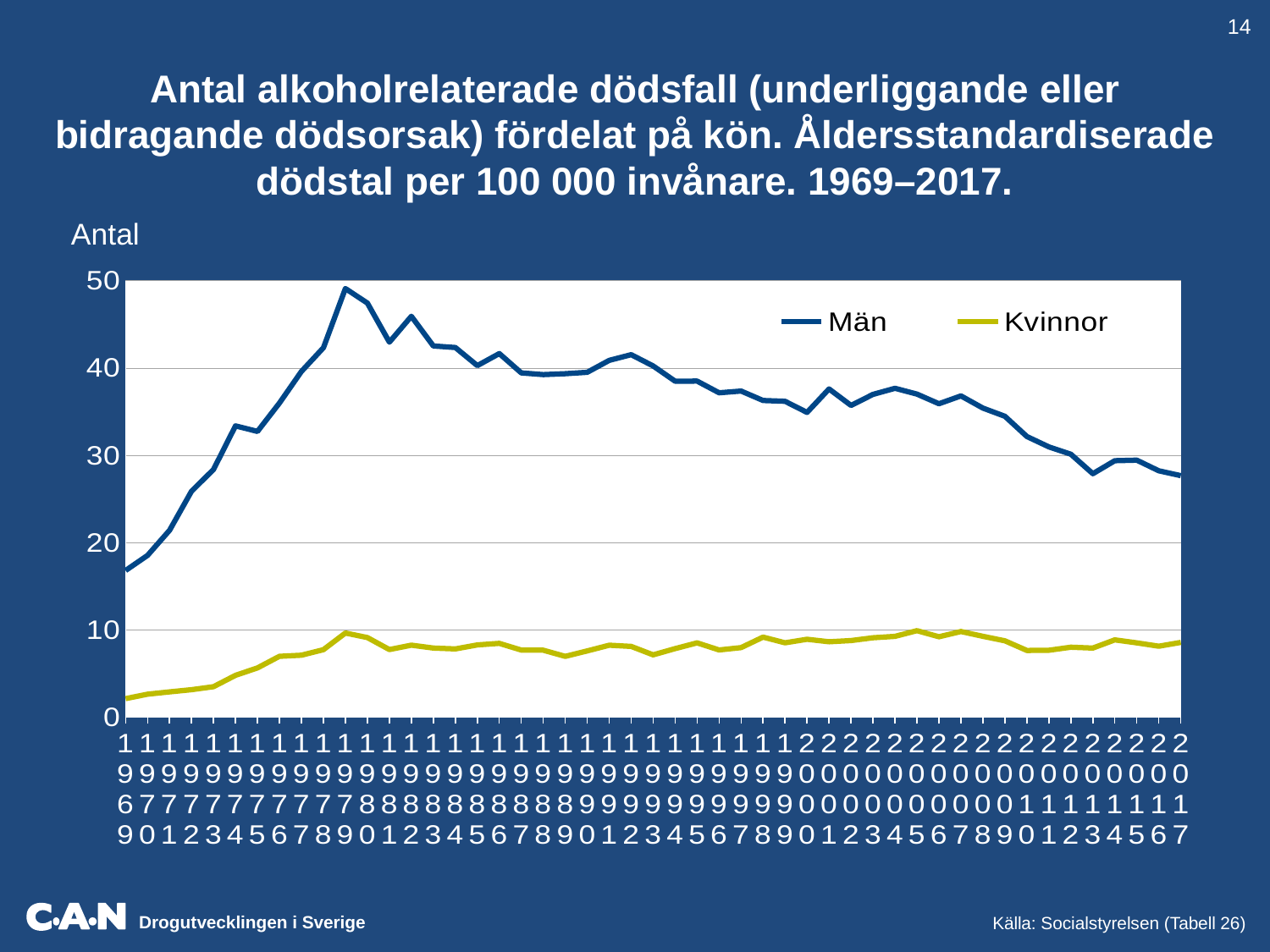
Does the value for Män rise or fall from 2010 to 2017? Fall What is the label on the vertical axis? Antal How many years (data points per series) are plotted on the x axis? 49 Which series has the higher value in 2000, Män or Kvinnor? Män Does the value for Män rise or fall from 1969 to 1980? Rise Is the value for Män in 1969 greater or less than 20? less Which two series are listed in the legend? Män and Kvinnor Is the value for Män in 1980 greater or less than 40? greater How many series does the legend list? 2 Is the value for Män in 2017 greater or less than 30? less What kind of chart is shown on the slide? Line chart